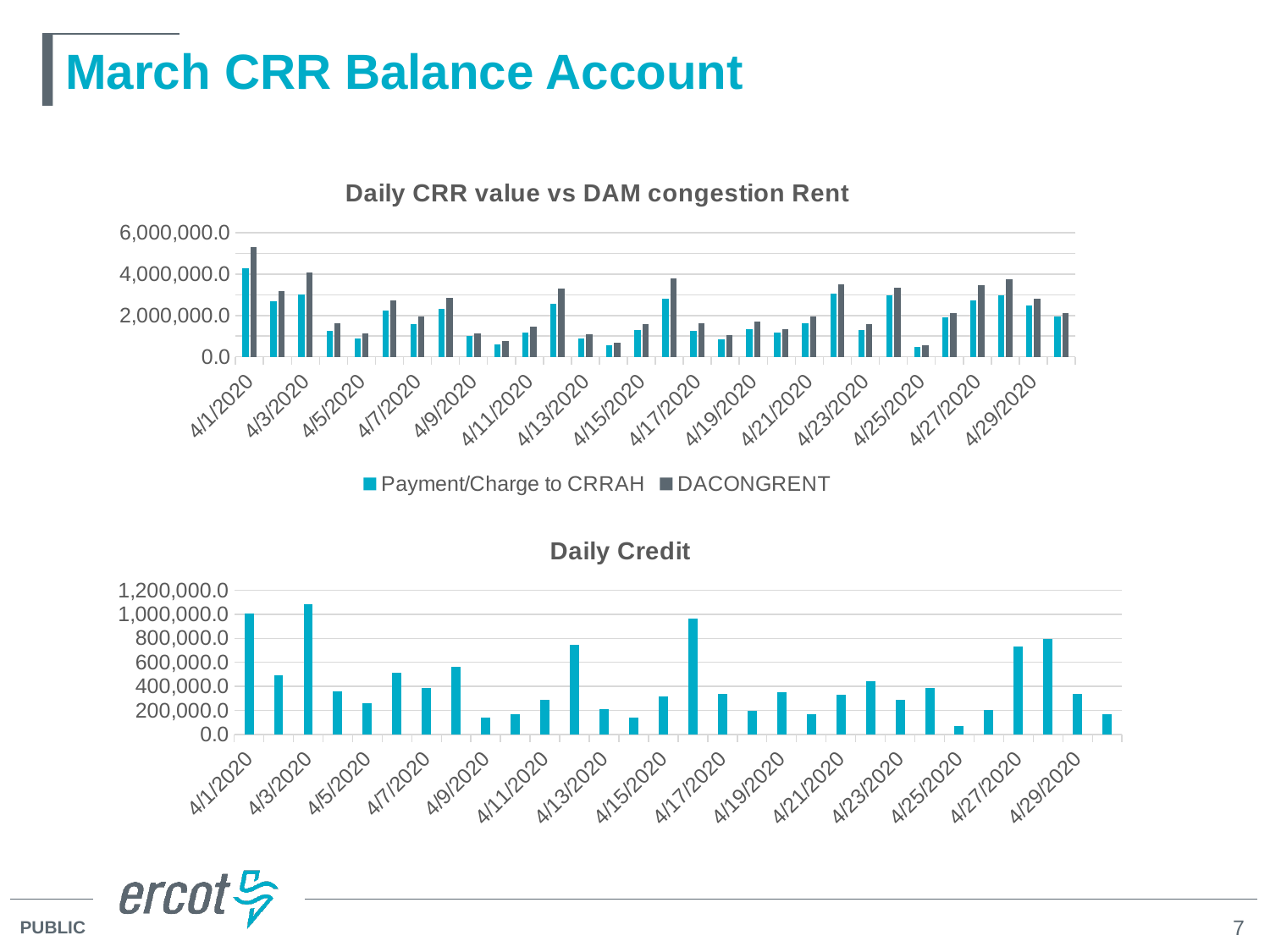
In the 'Daily Credit' chart, is the value for 4/3/2020 greater or less than 1,000,000.0? greater In the 'Daily Credit' chart, is the value for 4/25/2020 greater or less than 200,000.0? less In the 'Daily Credit' chart, which date has the highest value? 4/3/2020 In the 'Daily CRR value vs DAM congestion Rent' chart, which is larger for 4/1/2020: Payment/Charge to CRRAH or DACONGRENT? DACONGRENT What are the two legend entries in the 'Daily CRR value vs DAM congestion Rent' chart? Payment/Charge to CRRAH and DACONGRENT What kind of chart is the 'Daily Credit' chart? bar chart In the 'Daily CRR value vs DAM congestion Rent' chart, is the Payment/Charge to CRRAH value for 4/27/2020 greater or less than 2,000,000.0? greater In the 'Daily Credit' chart, which is larger: the value for 4/27/2020 or the value for 4/13/2020? 4/27/2020 How many series does the legend of the 'Daily CRR value vs DAM congestion Rent' chart list? 2 What is the title of the top chart on the slide? Daily CRR value vs DAM congestion Rent